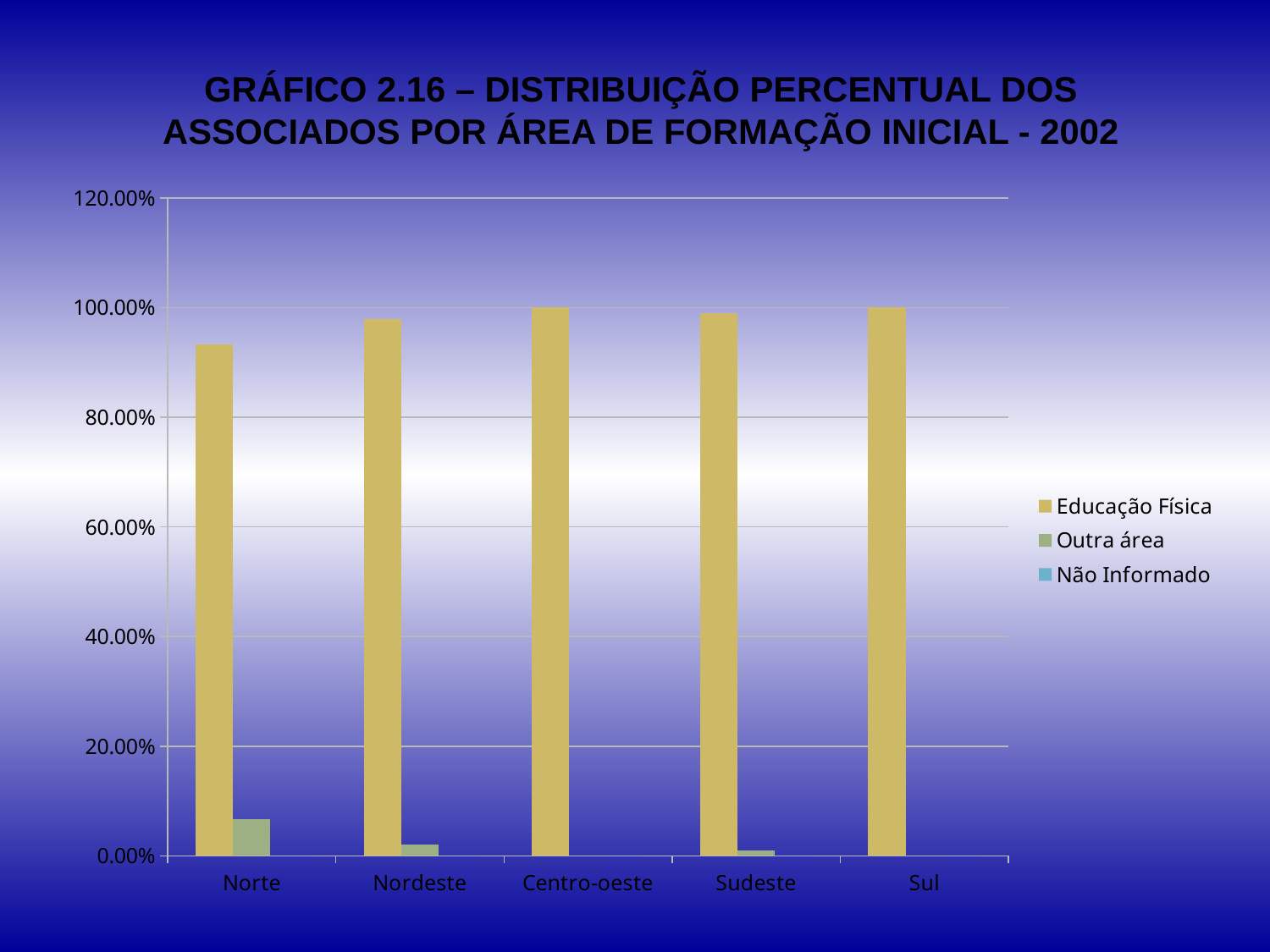
How many series does the chart's legend list? 3 Which year does the chart title refer to? 2002 Which region has the lowest Educação Física value? Norte What kind of chart is shown on the slide? bar chart Which region has the larger Educação Física value, Norte or Nordeste? Nordeste Is the Outra área value for Norte greater or less than 20.00%? less How many regions are shown on the x axis of the chart? 5 What are the three series listed in the chart's legend? Educação Física, Outra área, Não Informado Which region has the highest Outra área value? Norte Is the Educação Física value for Nordeste greater or less than 80.00%? greater Is the Educação Física value for Norte greater or less than 80.00%? greater Which region has the larger Outra área value, Norte or Nordeste? Norte